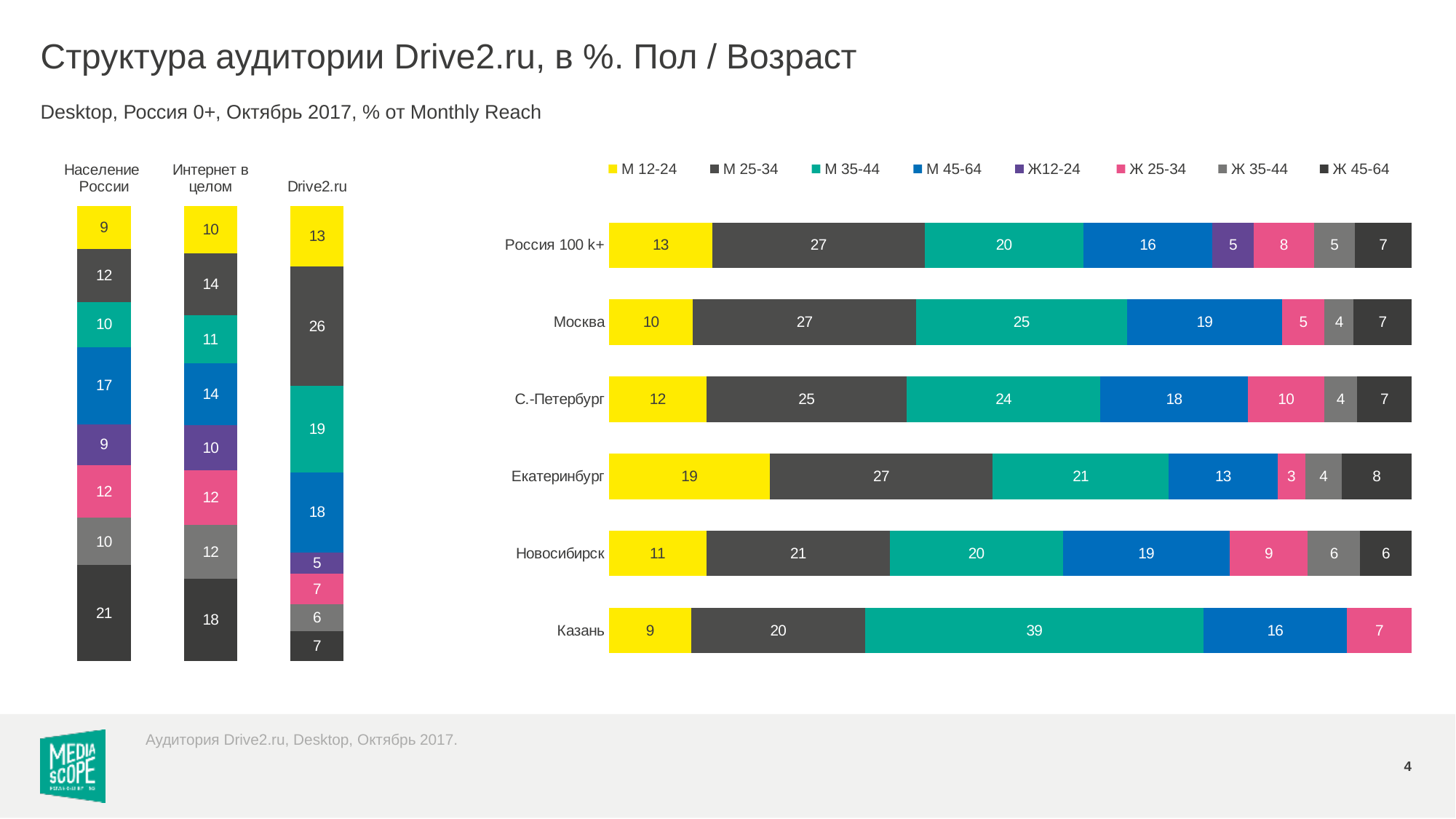
How many bars are shown in the left chart? 3 In the left chart, what is the value of the second segment from the top (dark grey) of the Drive2.ru bar? 26 In the right chart, what is the difference between the М 35-44 values for Казань and Москва? 14 In the right chart, what is the value of the М 35-44 segment for Казань? 39 In the left chart, which has the larger top (yellow) segment: Drive2.ru or Население России? Drive2.ru In the right chart, which city has the highest value for М 12-24? Екатеринбург In the right chart, what is the value of the М 25-34 segment for Новосибирск? 21 How many cities (bars) are shown in the right chart? 6 How many series does the legend of the right chart list? 8 In the right chart, what is the value of the Ж 25-34 segment for С.-Петербург? 10 In the right chart, which city has the lowest value for М 45-64? Екатеринбург What kind of chart is the right chart? Stacked bar chart